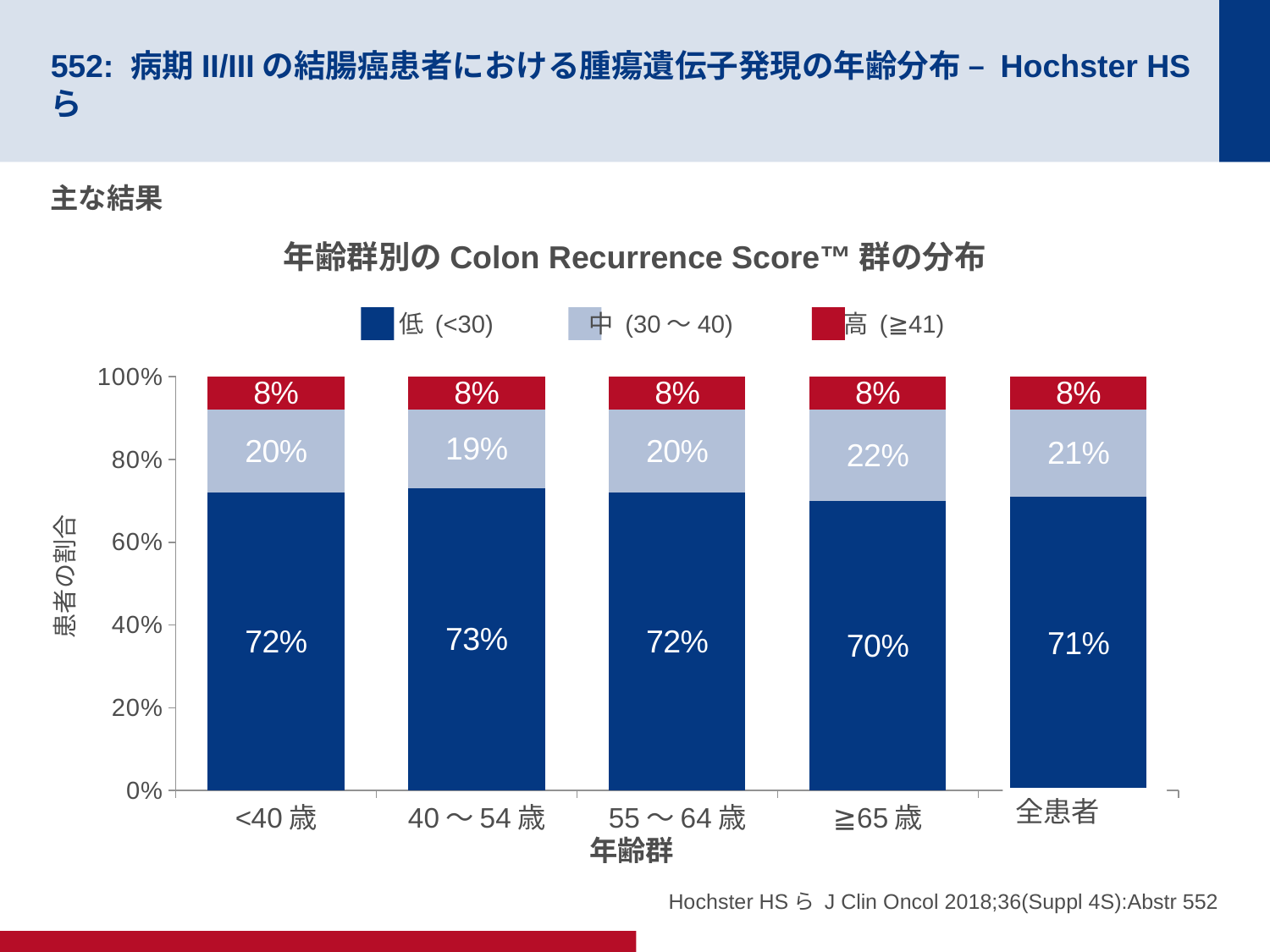
Which age group has the lowest value for the 低 (<30) group? ≧65 歳 What kind of chart is shown on the slide? Stacked bar chart Which age group has the highest value for the 低 (<30) group? 40～54 歳 How many series does the legend list? 3 What is the difference between the 低 (<30) values for 40～54 歳 and ≧65 歳? 3% What is the total of the stacked bar for 全患者? 100% What share of 全患者 is in the 高 (≧41) group? 8% What is the value for the 中 (30～40) group among patients aged ≧65 歳? 22% What percentage of patients aged <40 歳 fall in the 低 (<30) group? 72% Which is larger: the 中 (30～40) value for ≧65 歳 or for 40～54 歳? ≧65 歳 How many age-group categories are shown on the x axis? 5 What is the value for the 中 (30～40) group among patients aged 40～54 歳? 19%